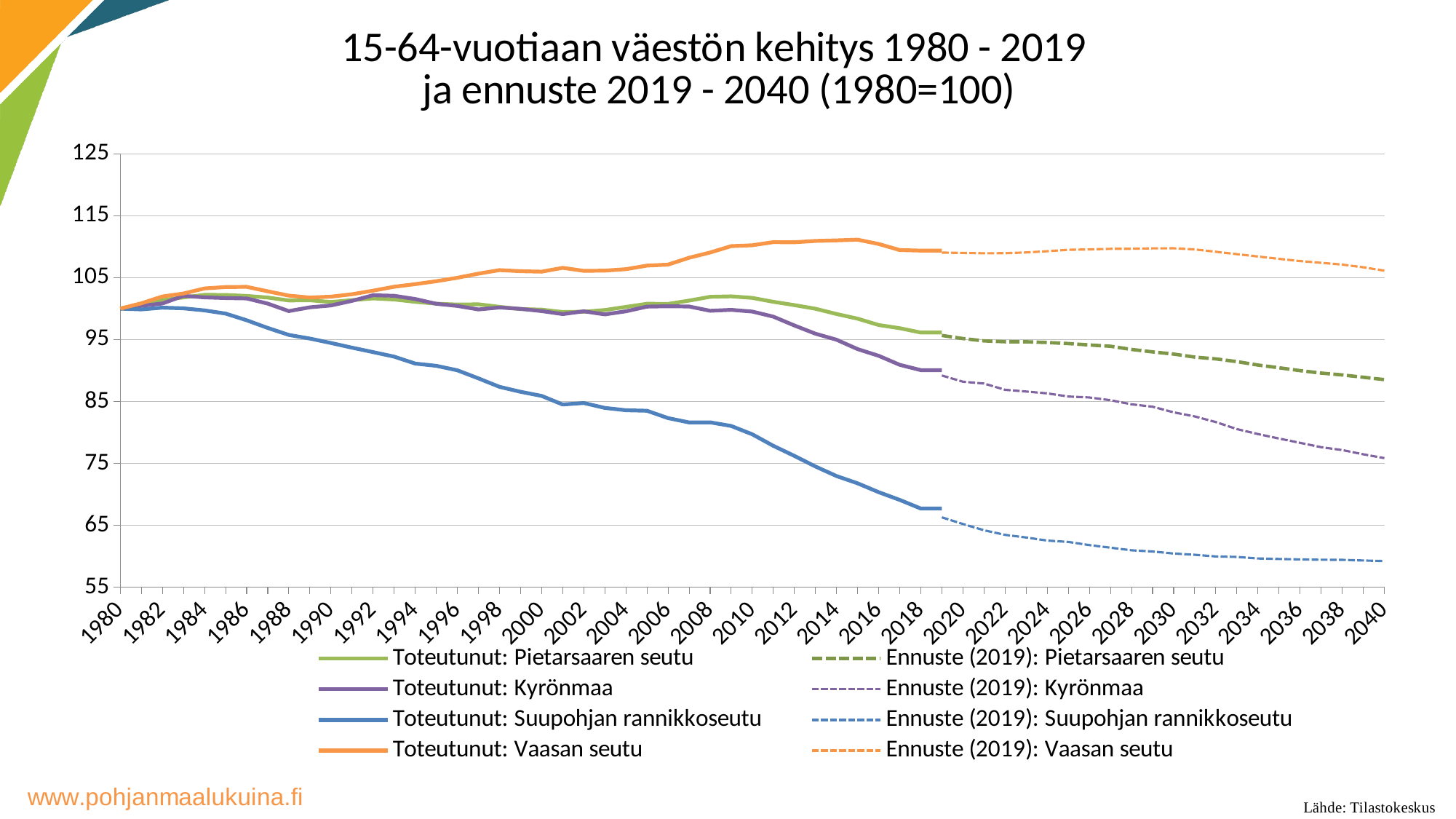
Which is larger in 2019, the value for Vaasan seutu or the value for Suupohjan rannikkoseutu? Vaasan seutu Is the forecast value for Pietarsaaren seutu in 2040 greater or less than 95? less What kind of chart is shown on the slide? line chart Is the forecast value for Kyrönmaa in 2040 greater or less than 85? less What is the index value for all regions in 1980? 100 Does the line for Suupohjan rannikkoseutu rise or fall from 1980 to 2040? fall Which region has the highest value in 2040? Vaasan seutu How many series does the legend list? 8 Is the value for Vaasan seutu in 2015 greater or less than 105? greater According to the note at the bottom right, what is the source of the data? Tilastokeskus Which region has the lowest value in 2040? Suupohjan rannikkoseutu